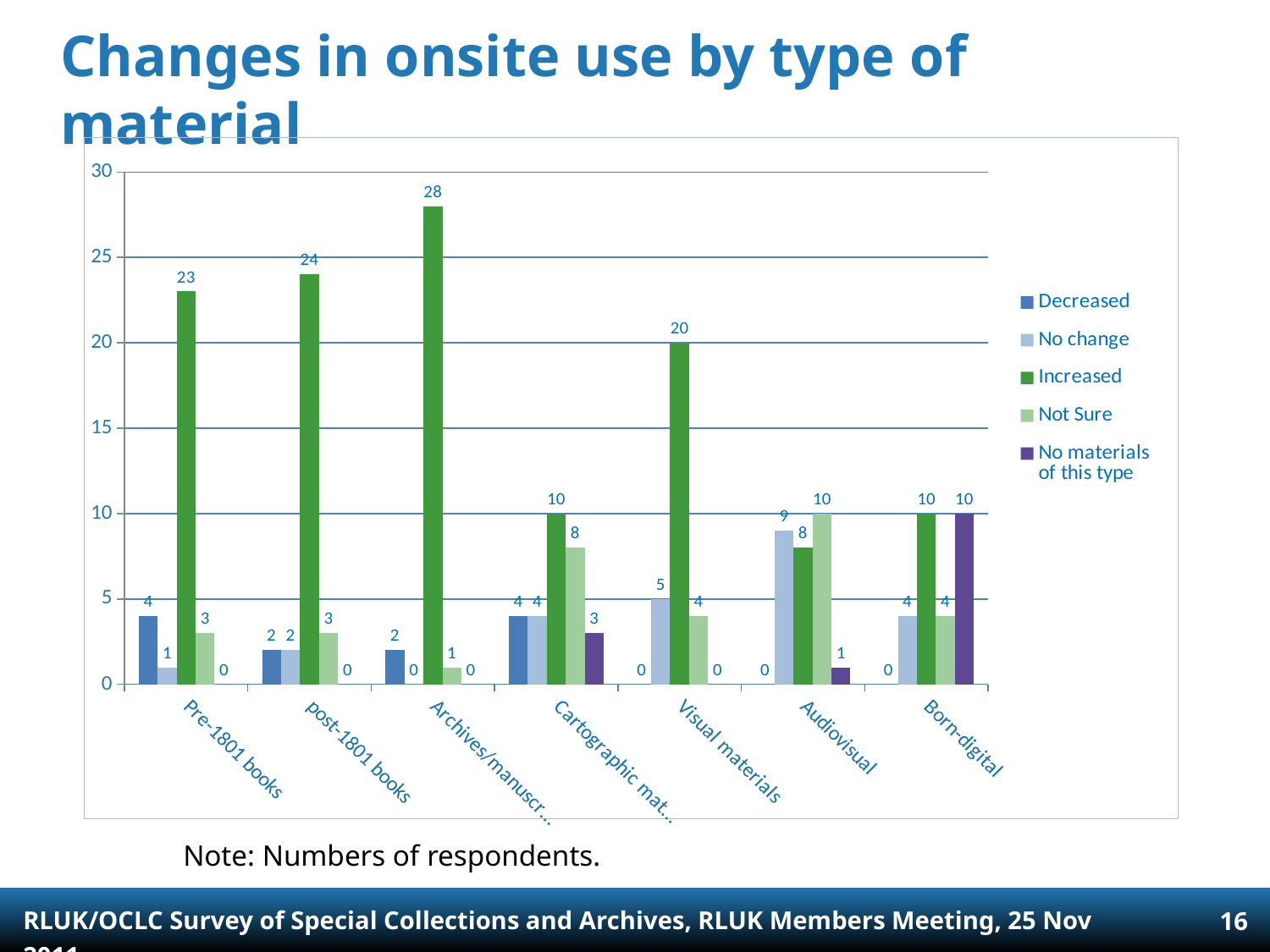
What is the difference between the Increased values for post-1801 books and Visual materials? 4 How many series does the legend list? 5 What is the value for No change for Audiovisual? 9 Which category has the lowest Increased value? Audiovisual What is the value for Not Sure for Cartographic materials? 8 What is the title of the chart on the slide? Changes in onsite use by type of material How many categories are shown on the x axis? 7 Which category has the highest Increased value? Archives/manuscr… What is the value for Increased for Pre-1801 books? 23 Which is larger for Audiovisual: No change or Increased? No change What kind of chart is shown on the slide? Bar chart What is the value for No materials of this type for Born-digital? 10